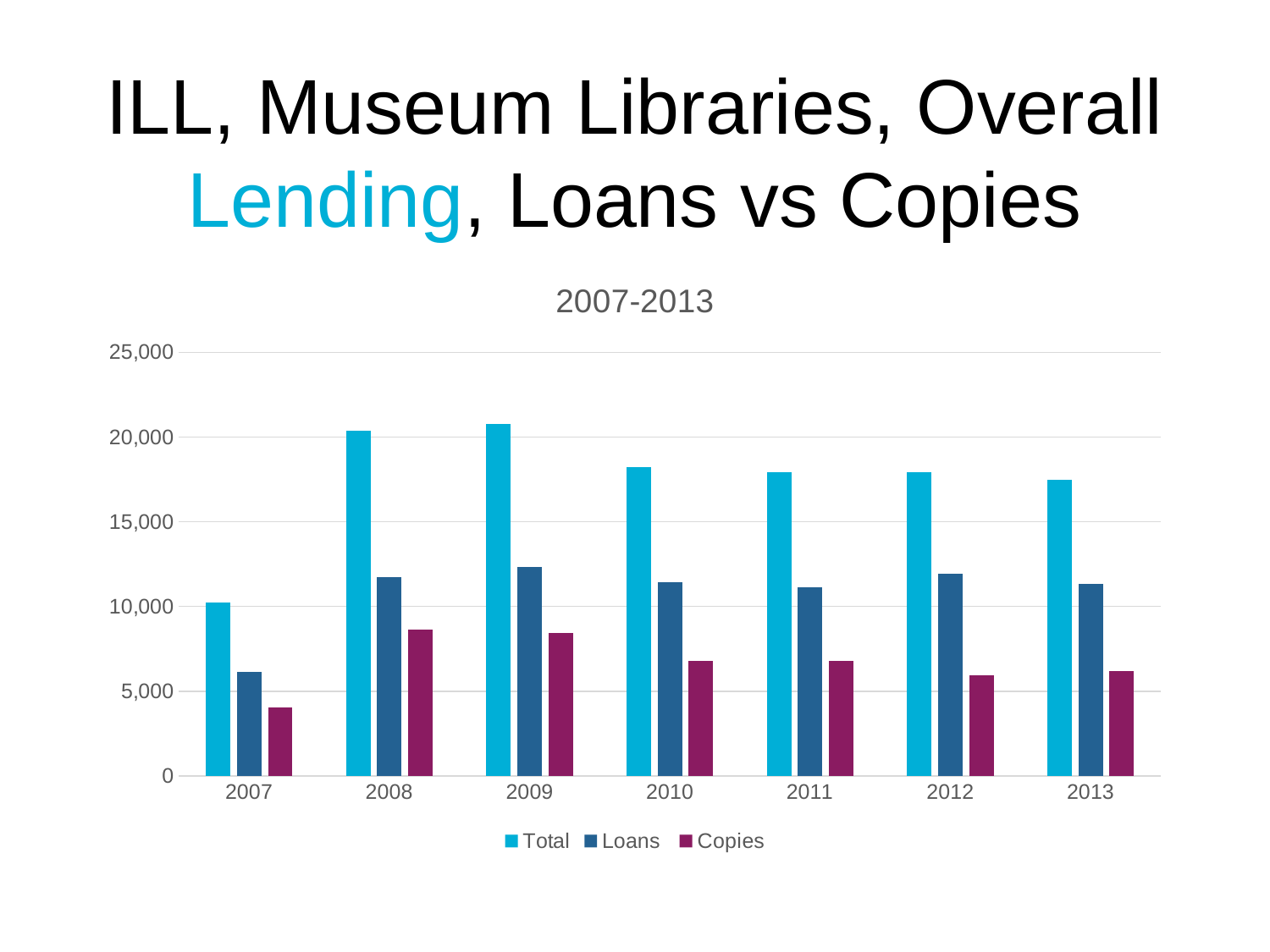
Which year has the lowest Total value? 2007 What kind of chart is shown on the slide? bar chart Is the Copies value for 2007 greater or less than 5,000? less Which is larger in 2008, Loans or Copies? Loans How many years are shown on the x axis? 7 Is the Total value for 2013 greater or less than 20,000? less Is the Loans value for 2009 greater or less than 10,000? greater Do the Total values rise or fall from 2009 to 2013? fall How many series does the legend list? 3 Which year has the lowest Loans value? 2007 Which year has the lowest Copies value? 2007